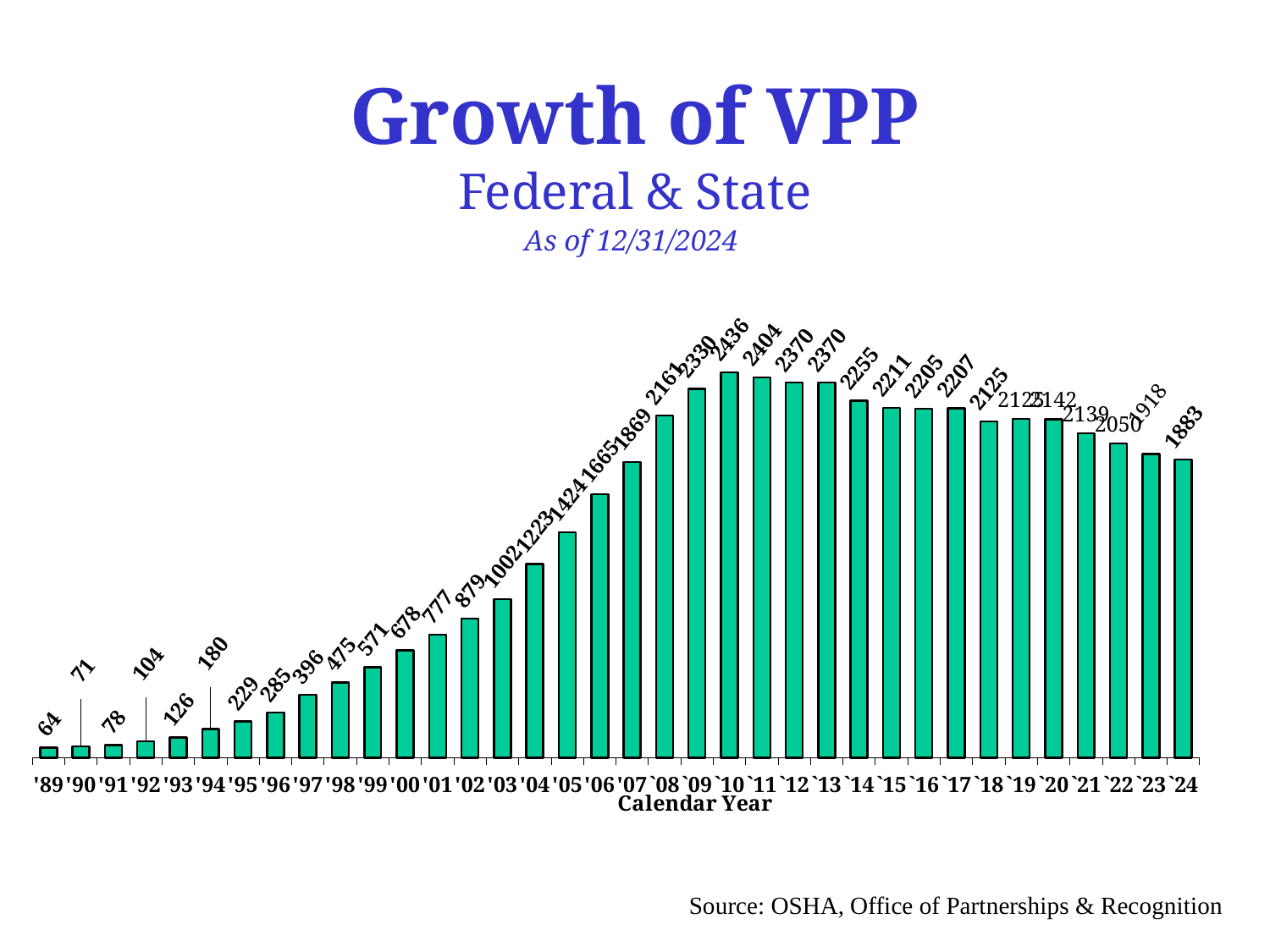
What is the value for '89? 64 What is the value for '24? 1883 Do the values rise or fall from '89 to '10? rise What is the difference between the values for '10 and '11? 32 What is the value for '10? 2436 What is the difference between the values for '23 and '24? 35 What kind of chart is this? bar chart Which is larger, the value for '08 or the value for '09? '09 What is the value for '03? 1002 Which year has the highest value? '10 Which year has the lowest value? '89 How many years are shown on the x axis? 36